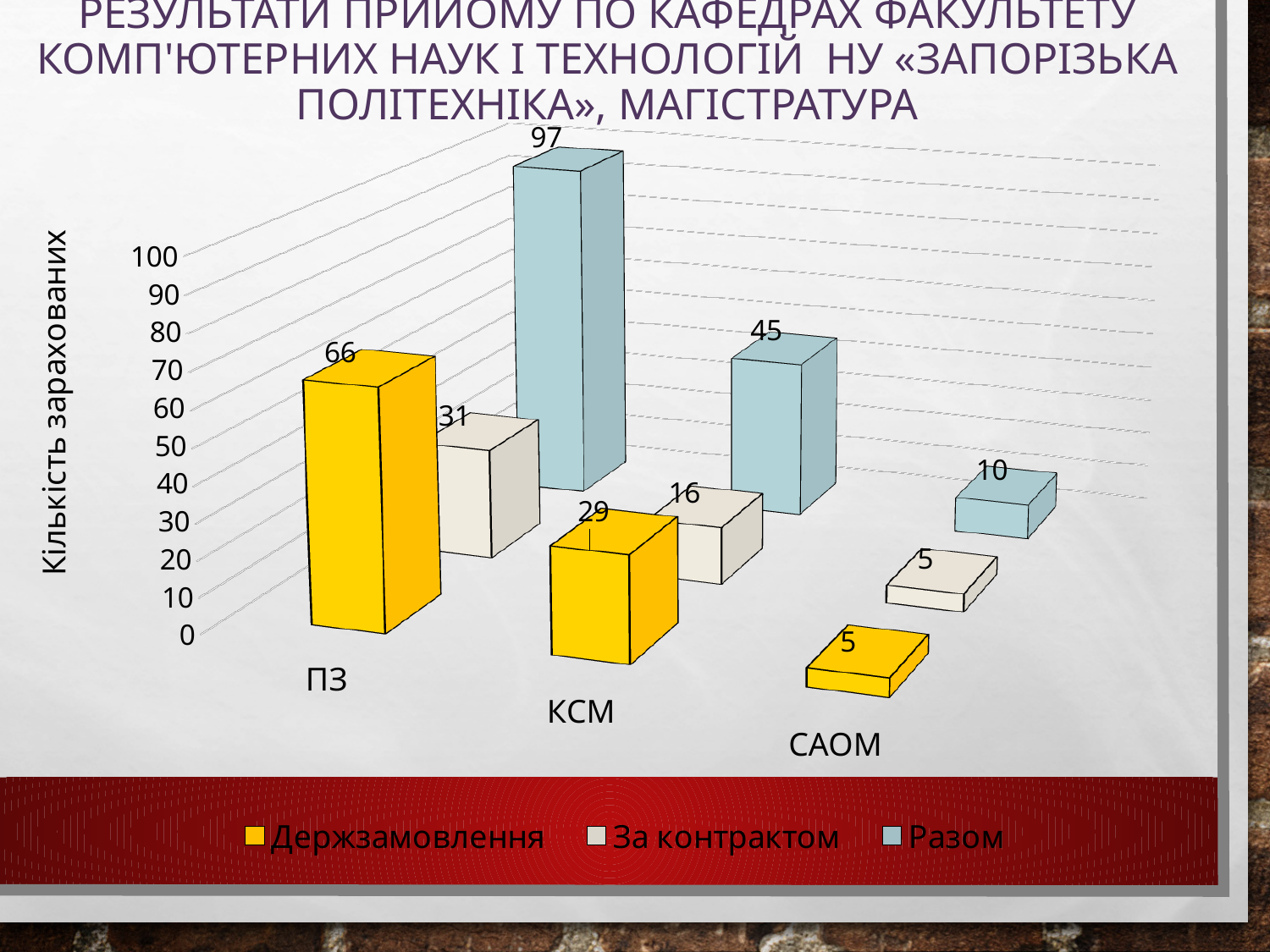
What is the value of За контрактом for САОМ? 5 What is the value of Держзамовлення for ПЗ? 66 What is the value of За контрактом for ПЗ? 31 What kind of chart is shown on the slide? Bar chart How many series does the legend list? 3 What is the value of Разом for КСМ? 45 What is the difference between the Разом values for ПЗ and КСМ? 52 How many categories are shown on the x axis? 3 Which is larger: Держзамовлення for КСМ or За контрактом for ПЗ? За контрактом for ПЗ Which category has the lowest Держзамовлення value? САОМ Which category has the highest Разом value? ПЗ What is the label of the vertical axis? Кількість зарахованих